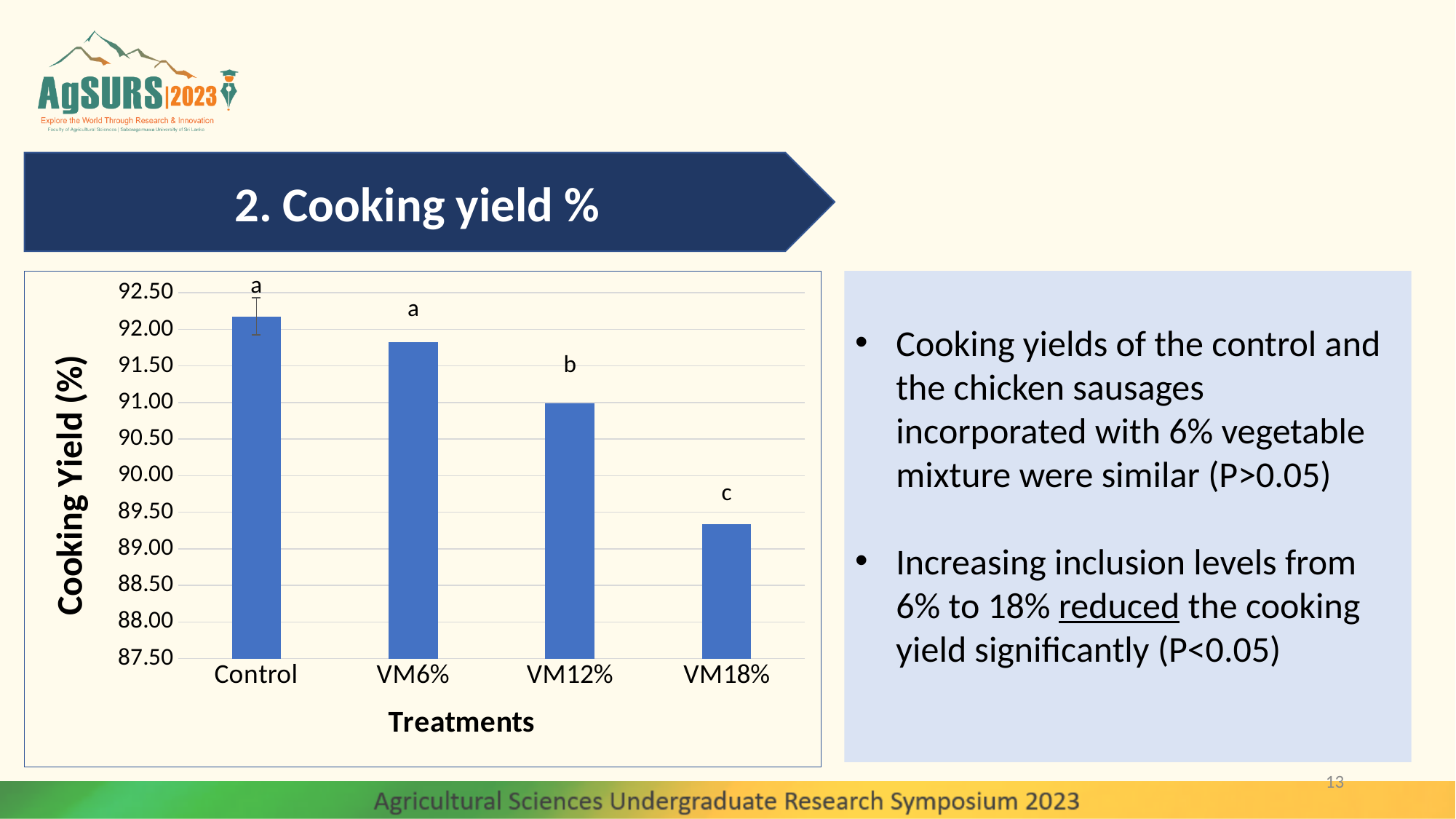
What kind of chart is shown on the slide? bar chart Do the cooking yield values rise or fall from Control to VM18% along the x axis? fall Which has a higher cooking yield, VM6% or VM12%? VM6% Is the cooking yield for Control greater or less than 92.00? greater Which treatment has the lowest cooking yield? VM18% What letter is printed above the VM12% bar? b How many treatments are plotted on the x axis of the chart? 4 Is the cooking yield for VM6% greater or less than 91.50? greater Which treatment has the highest cooking yield? Control What is the title of the y axis of the chart? Cooking Yield (%) Which has a higher cooking yield, VM12% or VM18%? VM12% Is the cooking yield for VM18% greater or less than 89.50? less